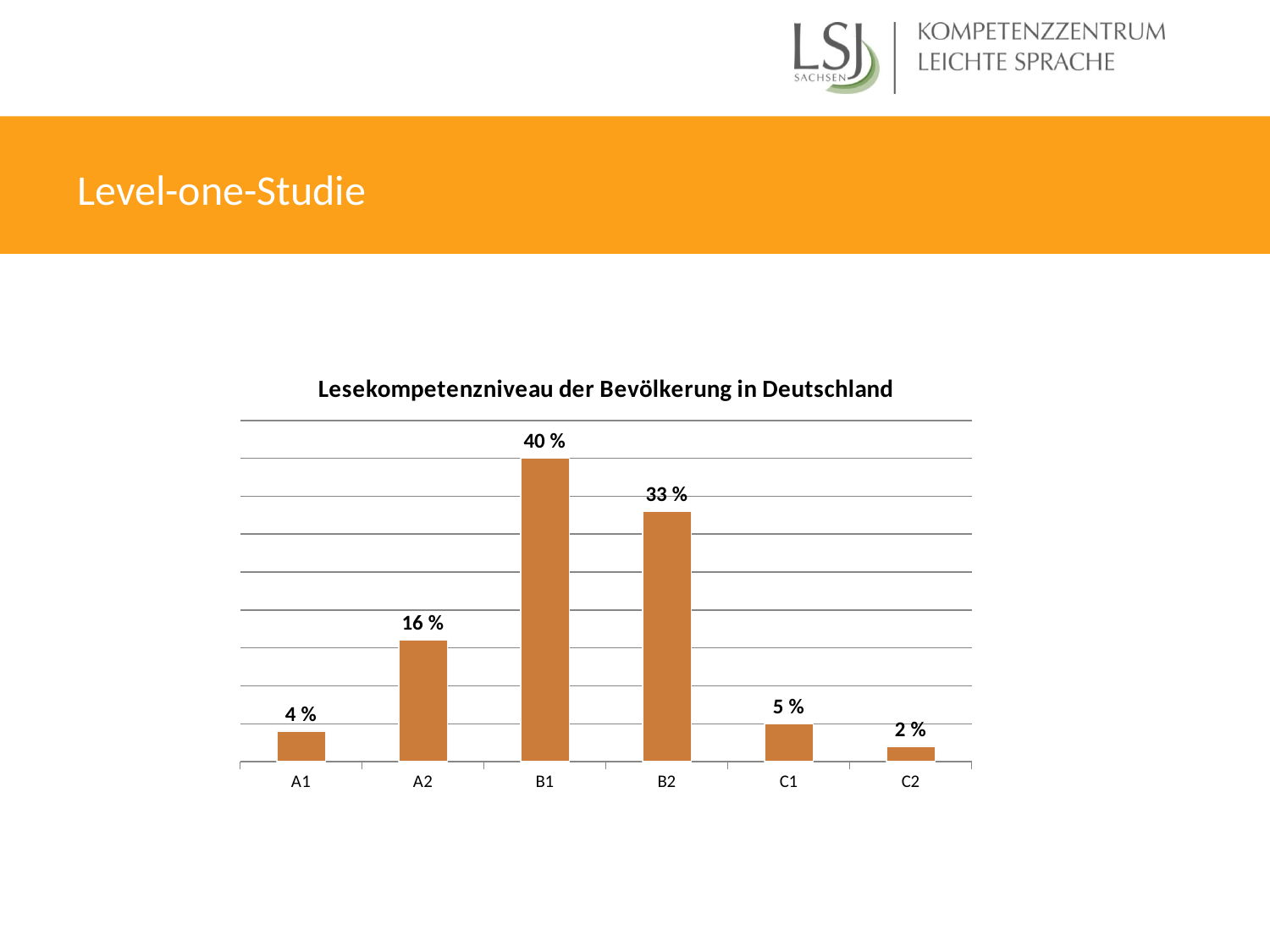
What is the difference between the values for B1 and B2? 7 % Which category has the lowest value? C2 Which is larger, the value for C1 or the value for A1? C1 What is the value for C2? 2 % How many categories are shown on the x axis? 6 What is the title of the chart? Lesekompetenzniveau der Bevölkerung in Deutschland What is the value for A2? 16 % What colour are the bars in the chart? Orange What kind of chart is shown? Bar chart Which category has the highest value? B1 What is the difference between the values for A2 and A1? 12 % What is the value for B1? 40 %